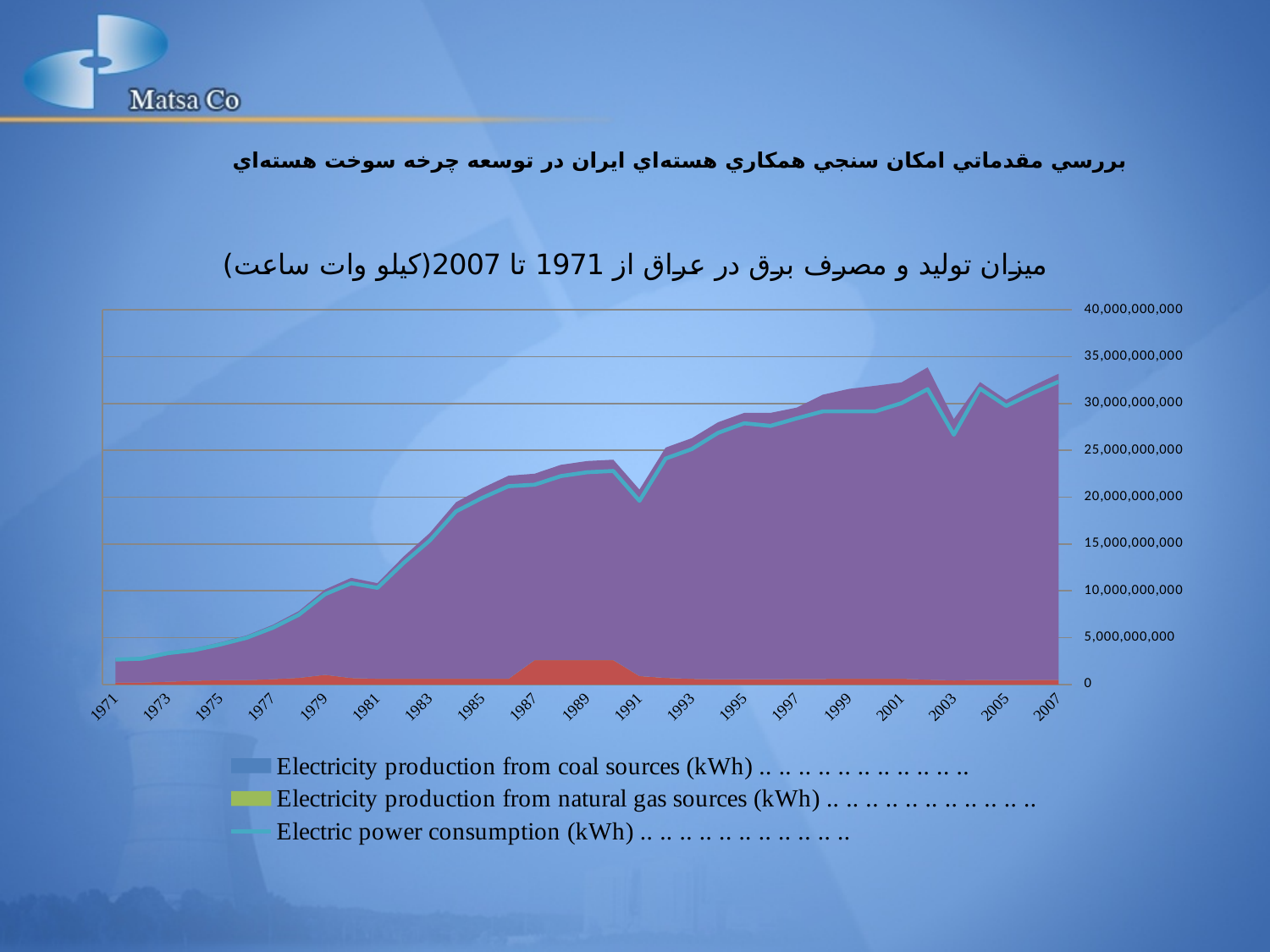
Which series is listed third in the legend? Electric power consumption (kWh) Is the value for Electric power consumption (kWh) in 1971 greater or less than 5,000,000,000? less What is the first year shown on the x axis? 1971 How many series does the legend list? 3 Is the value for Electric power consumption (kWh) in 1991 greater or less than 25,000,000,000? less Is the value for Electric power consumption (kWh) in 1995 greater or less than 25,000,000,000? greater What is the highest value shown on the y axis? 40,000,000,000 What kind of chart is shown on the slide? combination area and line chart What is the last year shown on the x axis? 2007 Does Electric power consumption (kWh) generally rise or fall from 1971 to 2007? rise